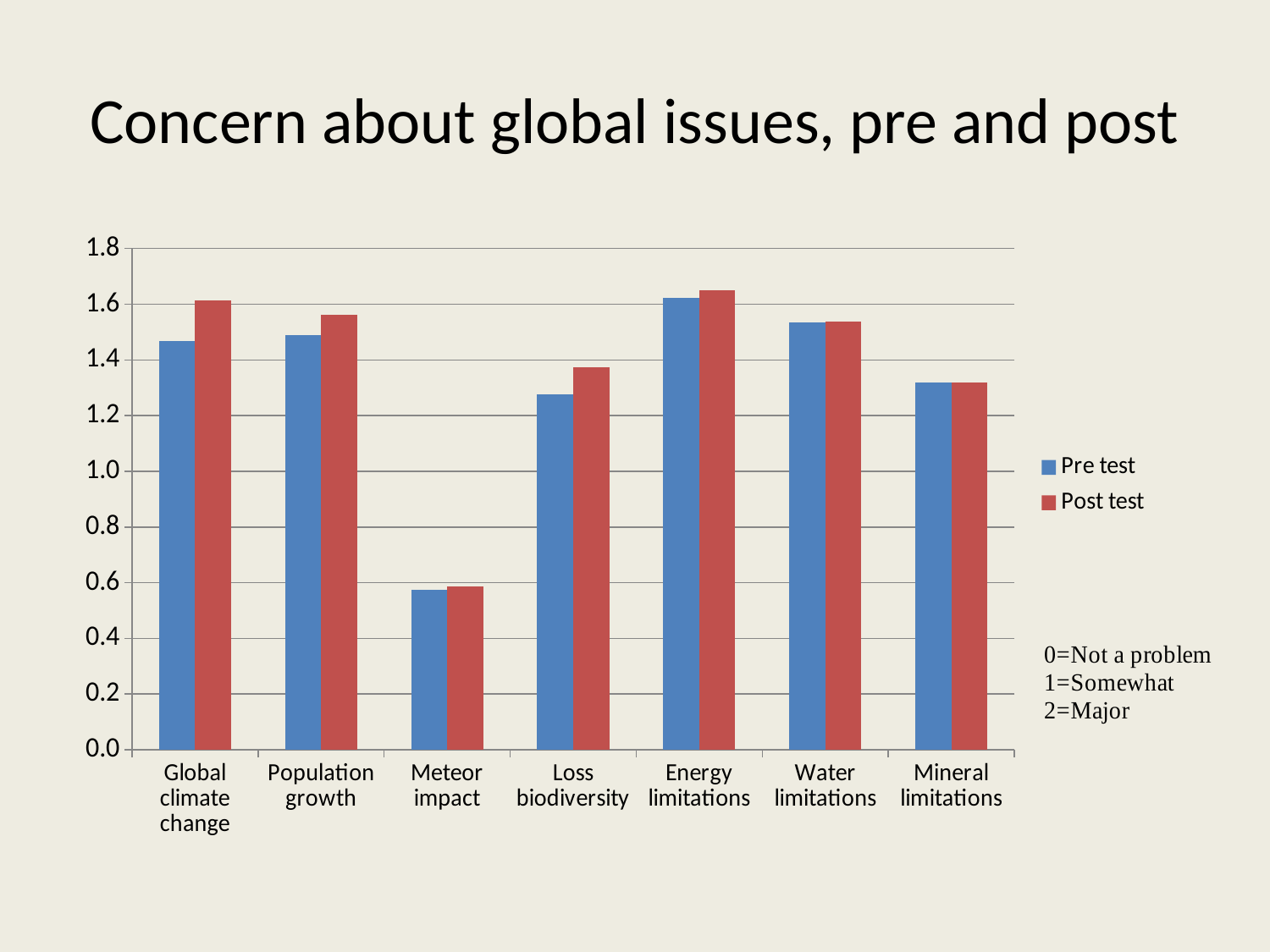
Is the Pre test value for Mineral limitations greater or less than 1.4? less What is the title of the chart? Concern about global issues, pre and post How many categories are shown on the x axis? 7 Is the Pre test value for Meteor impact greater or less than 0.8? less What kind of chart is shown on the slide? bar chart For Global climate change, which is larger: the Pre test or the Post test value? Post test Which category has the lowest Post test value? Meteor impact Which category has the lowest Pre test value? Meteor impact Which category has the highest Pre test value? Energy limitations Is the Post test value for Loss biodiversity greater or less than 1.2? greater For Loss biodiversity, which is larger: the Pre test or the Post test value? Post test How many series does the legend list? 2